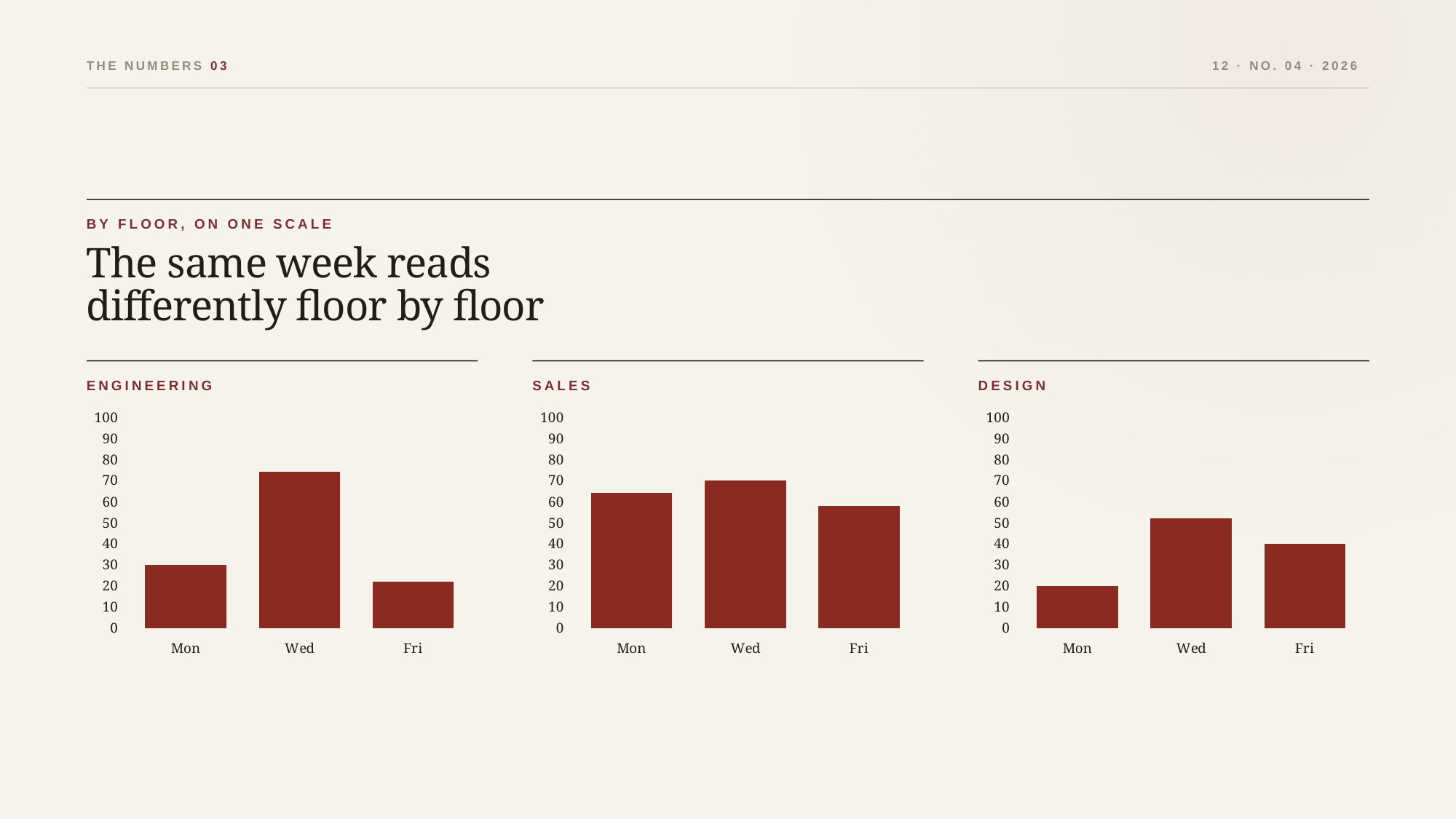
What is the title of the chart on the right of the slide? DESIGN What kind of chart is the Sales chart? Bar chart In the Design chart, which day has the highest value? Wed In the Sales chart, is the value for Mon greater or less than 50? greater In the Engineering chart, which day has the highest value? Wed In the Design chart, which day has the lowest value? Mon In the Engineering chart, which day has the lowest value? Fri In the Design chart, is the value for Fri greater or less than 50? less In the Engineering chart, is the value for Wed greater or less than 60? greater In the Sales chart, which day has the lowest value? Fri How many days are shown on the x axis of the Design chart? 3 In the Sales chart, which is larger, the value for Wed or the value for Fri? Wed